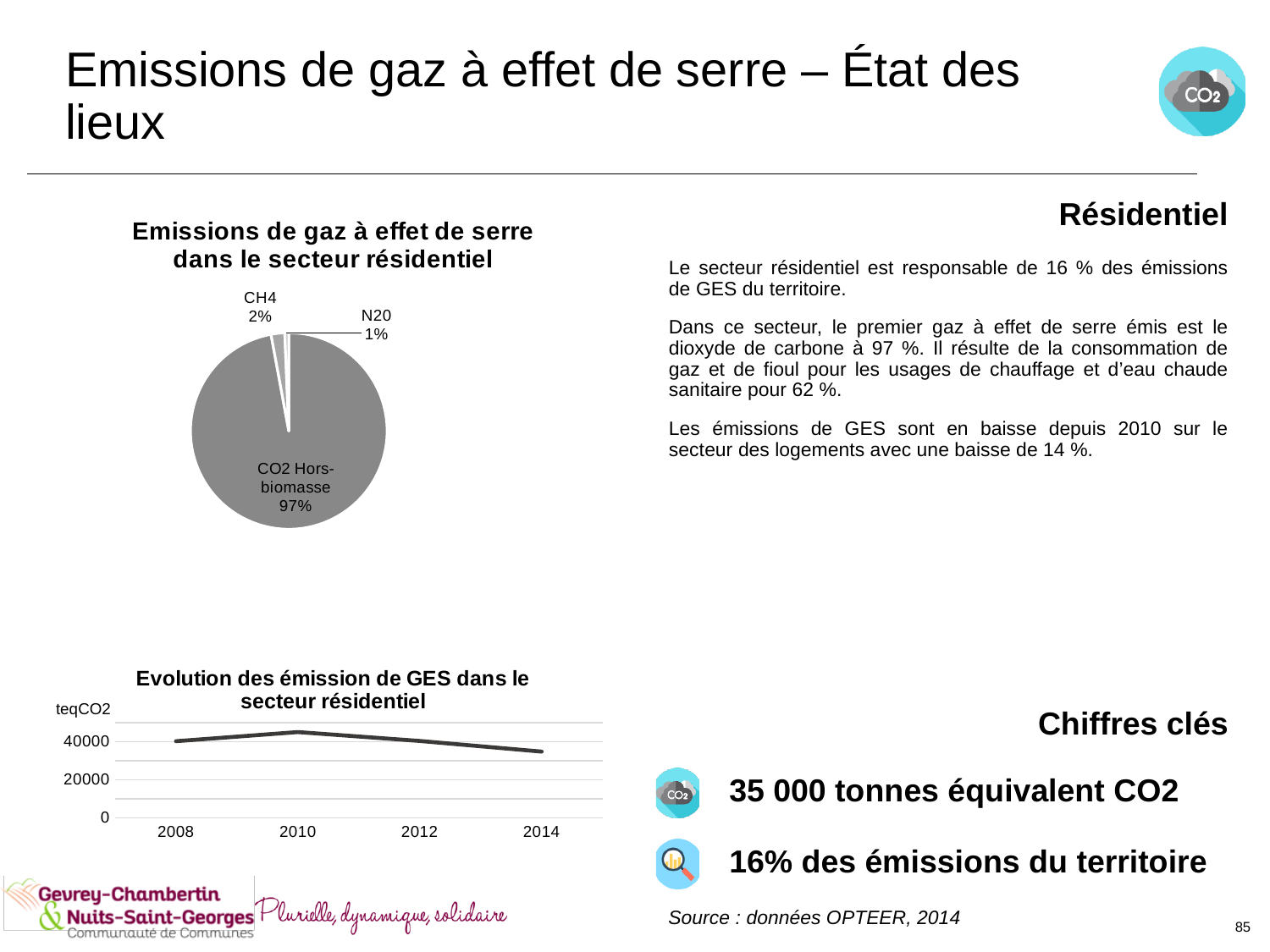
In the pie chart 'Emissions de gaz à effet de serre dans le secteur résidentiel', what share does N2O have? 1% In the pie chart 'Emissions de gaz à effet de serre dans le secteur résidentiel', what share does CO2 Hors-biomasse have? 97% In the chart 'Evolution des émission de GES dans le secteur résidentiel', which year has the lowest value? 2014 In the pie chart 'Emissions de gaz à effet de serre dans le secteur résidentiel', what is the difference in percentage points between CH4 and N2O? 1% In the chart 'Evolution des émission de GES dans le secteur résidentiel', do the values rise or fall between 2010 and 2014? fall In the pie chart 'Emissions de gaz à effet de serre dans le secteur résidentiel', how many slices are there? 3 In the chart 'Evolution des émission de GES dans le secteur résidentiel', is the value for 2010 greater or less than 40000? greater In the chart 'Evolution des émission de GES dans le secteur résidentiel', which year has the highest value? 2010 In the pie chart 'Emissions de gaz à effet de serre dans le secteur résidentiel', which gas has the largest slice? CO2 Hors-biomasse In the pie chart 'Emissions de gaz à effet de serre dans le secteur résidentiel', which gas has the smallest slice? N20 What kind of chart is 'Evolution des émission de GES dans le secteur résidentiel'? Line chart In the pie chart 'Emissions de gaz à effet de serre dans le secteur résidentiel', what share does CH4 have? 2%